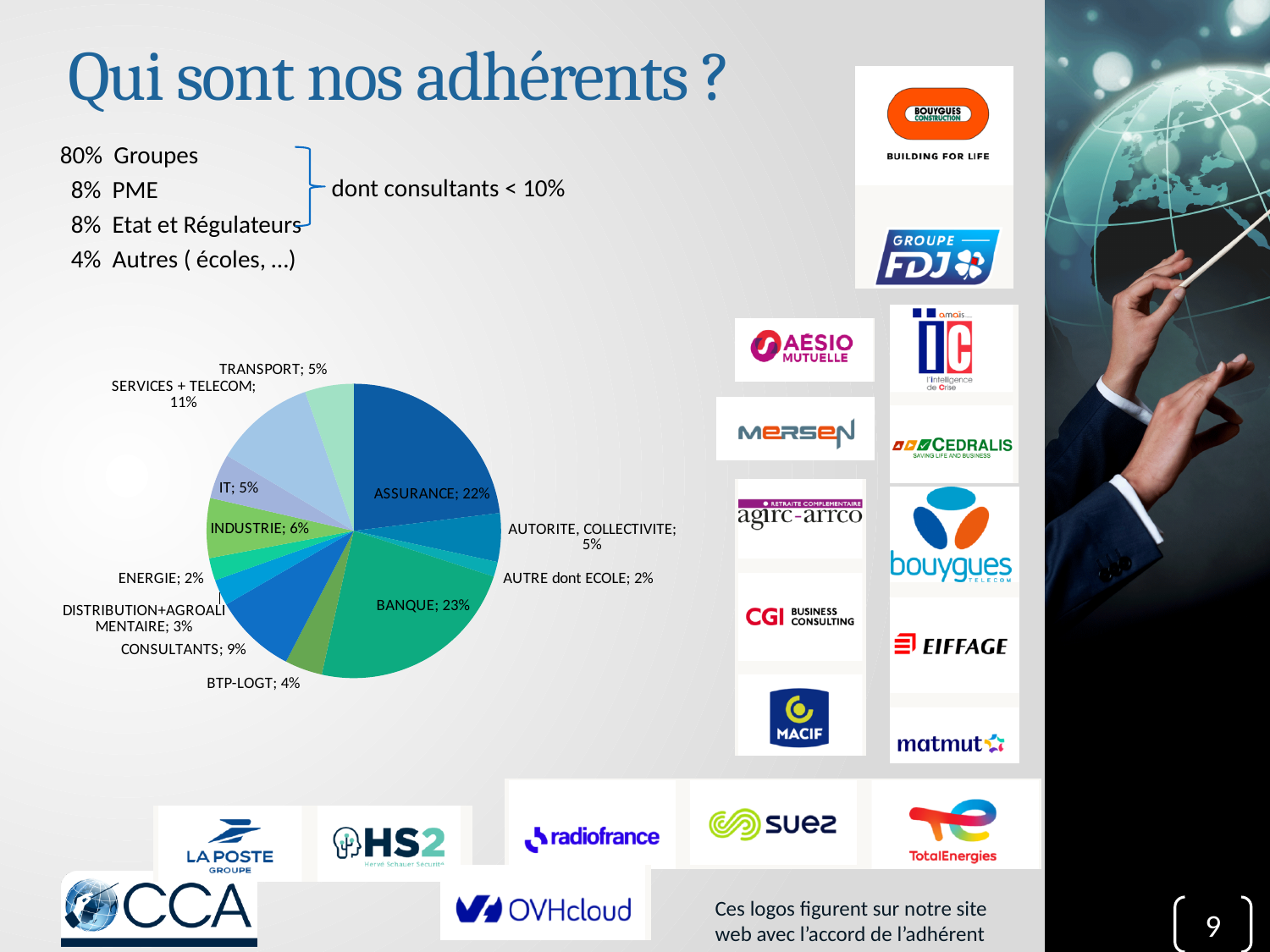
How many categories are shown in the pie chart? 12 What is the value for CONSULTANTS in the pie chart? 9% What type of chart is shown on the slide? pie chart What is the value shown for ASSURANCE in the pie chart? 22% What is the difference between the SERVICES + TELECOM and TRANSPORT shares in the pie chart? 6% Which category has the largest share in the pie chart? BANQUE What is the value shown for BTP-LOGT in the pie chart? 4% What percentage does the pie chart show for DISTRIBUTION+AGROALIMENTAIRE? 3% What is the difference between the BANQUE and CONSULTANTS shares in the pie chart? 14% Which is larger in the pie chart, INDUSTRIE or IT? INDUSTRIE What percentage is shown for SERVICES + TELECOM in the pie chart? 11% What share of the pie chart does BANQUE represent? 23%